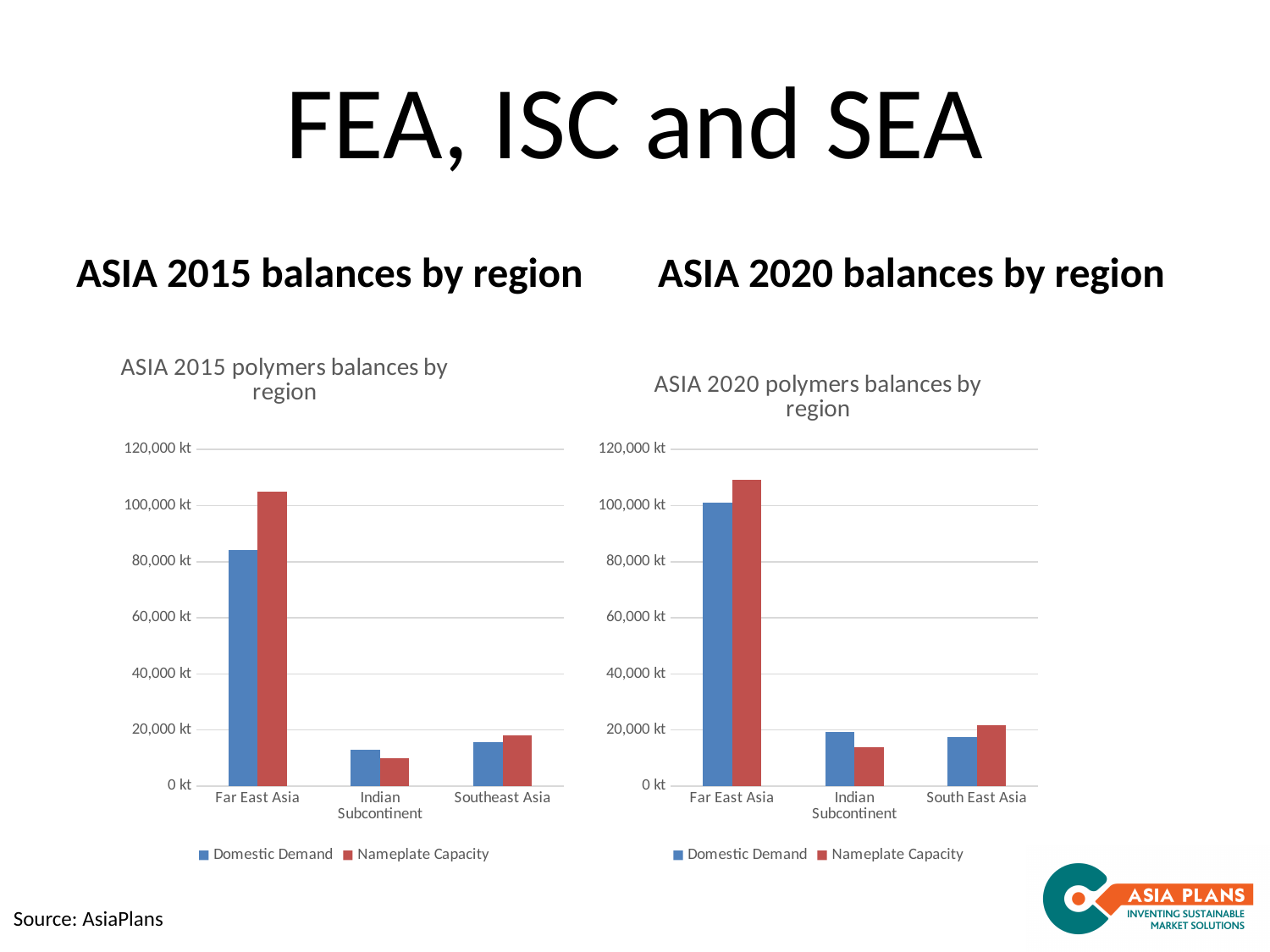
How many regions are shown on the x axis of the ASIA 2020 polymers balances by region chart? 3 In the ASIA 2015 polymers balances by region chart, which is larger for Indian Subcontinent: Domestic Demand or Nameplate Capacity? Domestic Demand In the ASIA 2015 polymers balances by region chart, which region has the highest Nameplate Capacity? Far East Asia In the ASIA 2015 polymers balances by region chart, which is larger for Southeast Asia: Domestic Demand or Nameplate Capacity? Nameplate Capacity In the ASIA 2015 polymers balances by region chart, is the Nameplate Capacity for Indian Subcontinent greater or less than 20,000 kt? less How many series does the legend of the ASIA 2015 polymers balances by region chart list? 2 In the ASIA 2020 polymers balances by region chart, is the Nameplate Capacity for Far East Asia greater or less than 100,000 kt? greater In the ASIA 2020 polymers balances by region chart, which is larger for Far East Asia: Domestic Demand or Nameplate Capacity? Nameplate Capacity In the ASIA 2015 polymers balances by region chart, is the Nameplate Capacity for Far East Asia greater or less than 100,000 kt? greater In the ASIA 2015 polymers balances by region chart, which region has the lowest Nameplate Capacity? Indian Subcontinent In the ASIA 2020 polymers balances by region chart, which region has the highest Domestic Demand? Far East Asia